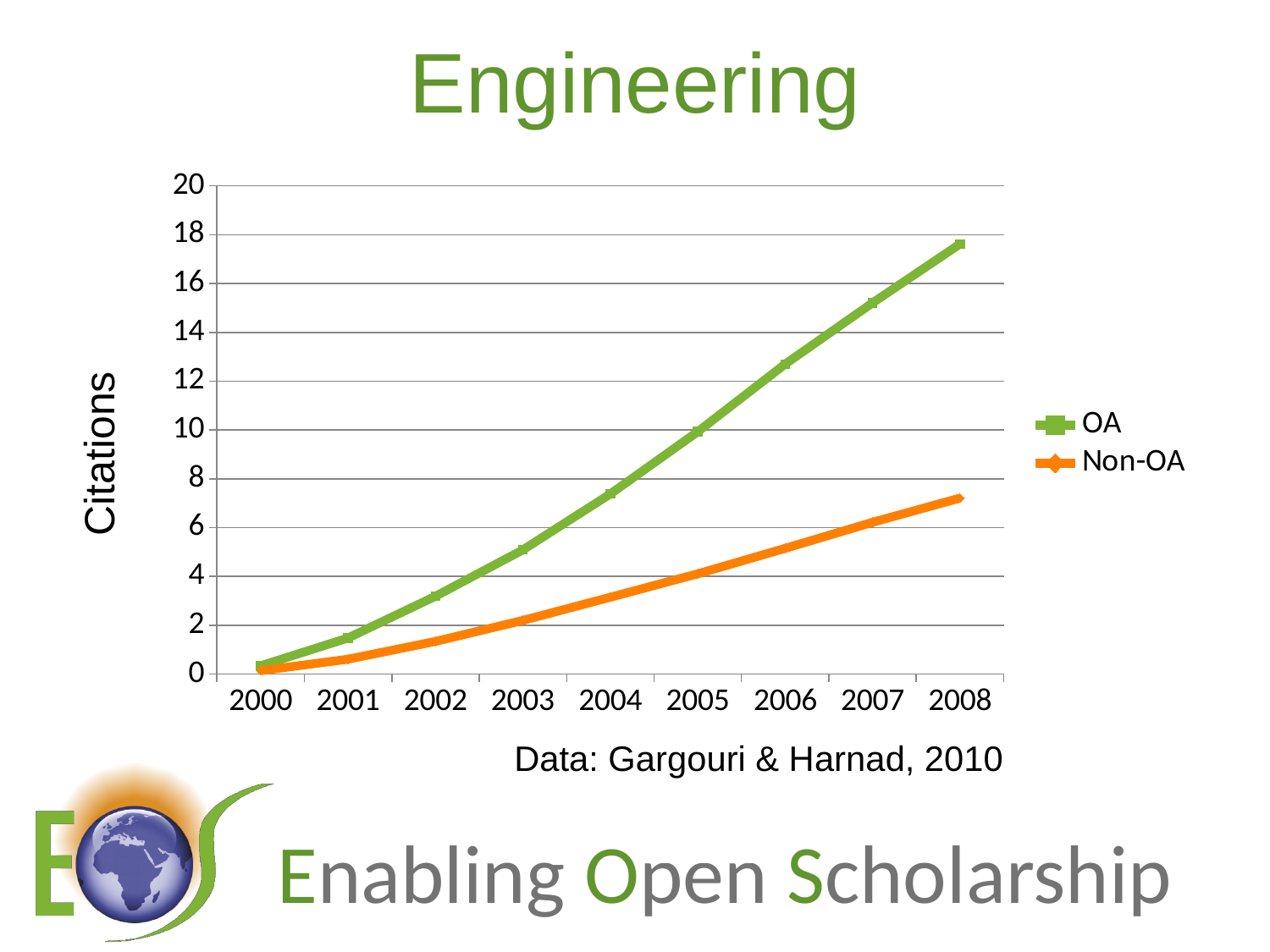
How many series does the legend list? 2 What kind of chart is shown on the slide? line chart In which year is the OA series at its highest? 2008 Do the OA citations rise or fall from 2000 to 2008? rise In which year is the Non-OA series at its lowest? 2000 In 2008, which series has more citations, OA or Non-OA? OA Is the OA value for 2008 greater or less than 16? greater What is the label on the vertical axis of the chart? Citations Is the Non-OA value for 2004 greater or less than 4? less Is the Non-OA value for 2008 greater or less than 8? less How many years are plotted along the x axis? 9